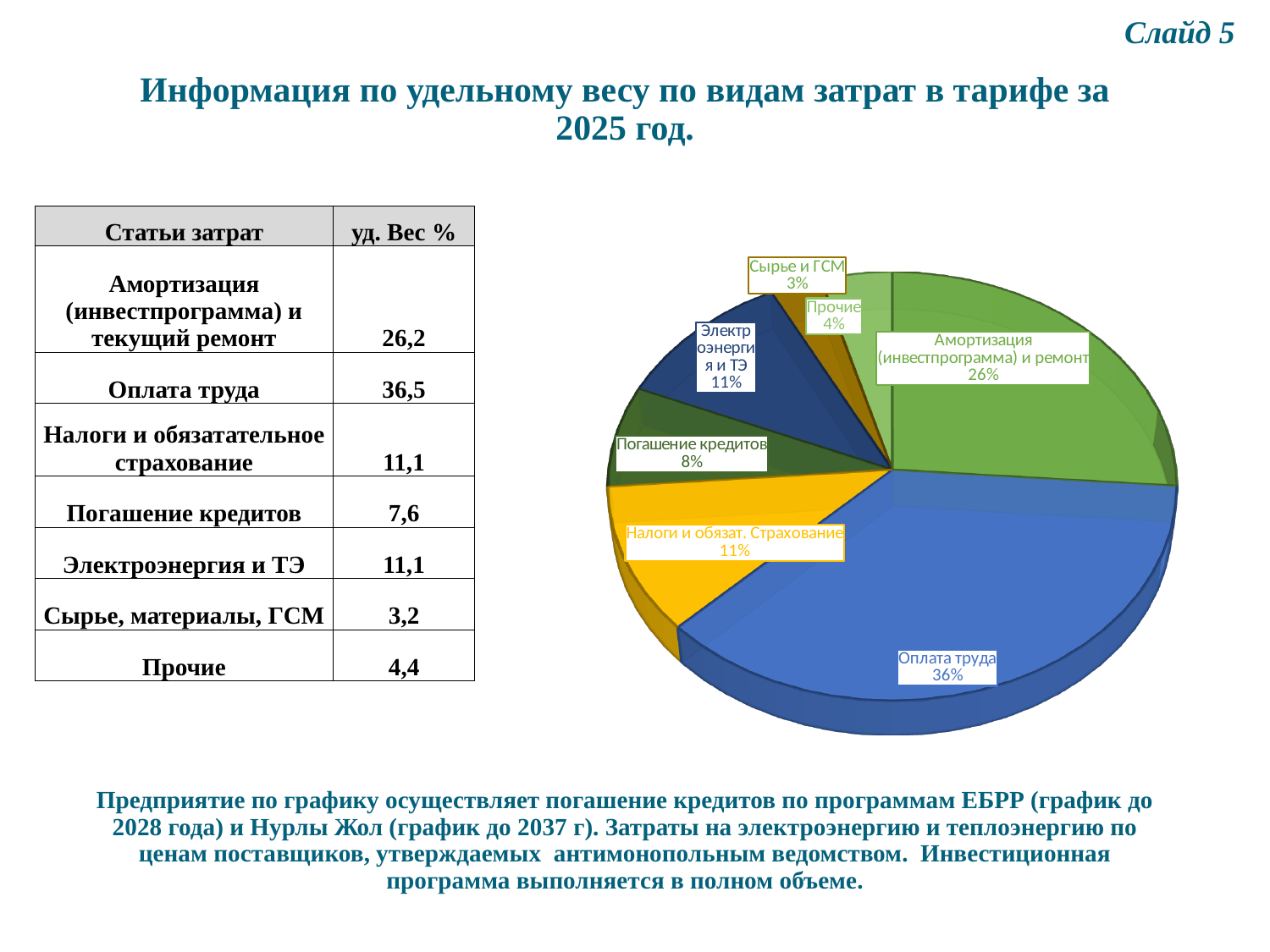
What is the difference in percentage points between "Оплата труда" and "Амортизация (инвестпрограмма) и ремонт" in the pie chart? 10 What kind of chart is shown on the slide? pie chart Which is larger in the pie chart, "Погашение кредитов" or "Электроэнергия и ТЭ"? Электроэнергия и ТЭ Which slice of the pie chart is the smallest? Сырье и ГСМ What share of the pie does "Сырье и ГСМ" have? 3% What share of the pie does "Оплата труда" have? 36% What colour is the "Оплата труда" slice in the pie chart? blue What share of the pie does "Погашение кредитов" have? 8% Which slice of the pie chart is the largest? Оплата труда How many slices does the pie chart have? 7